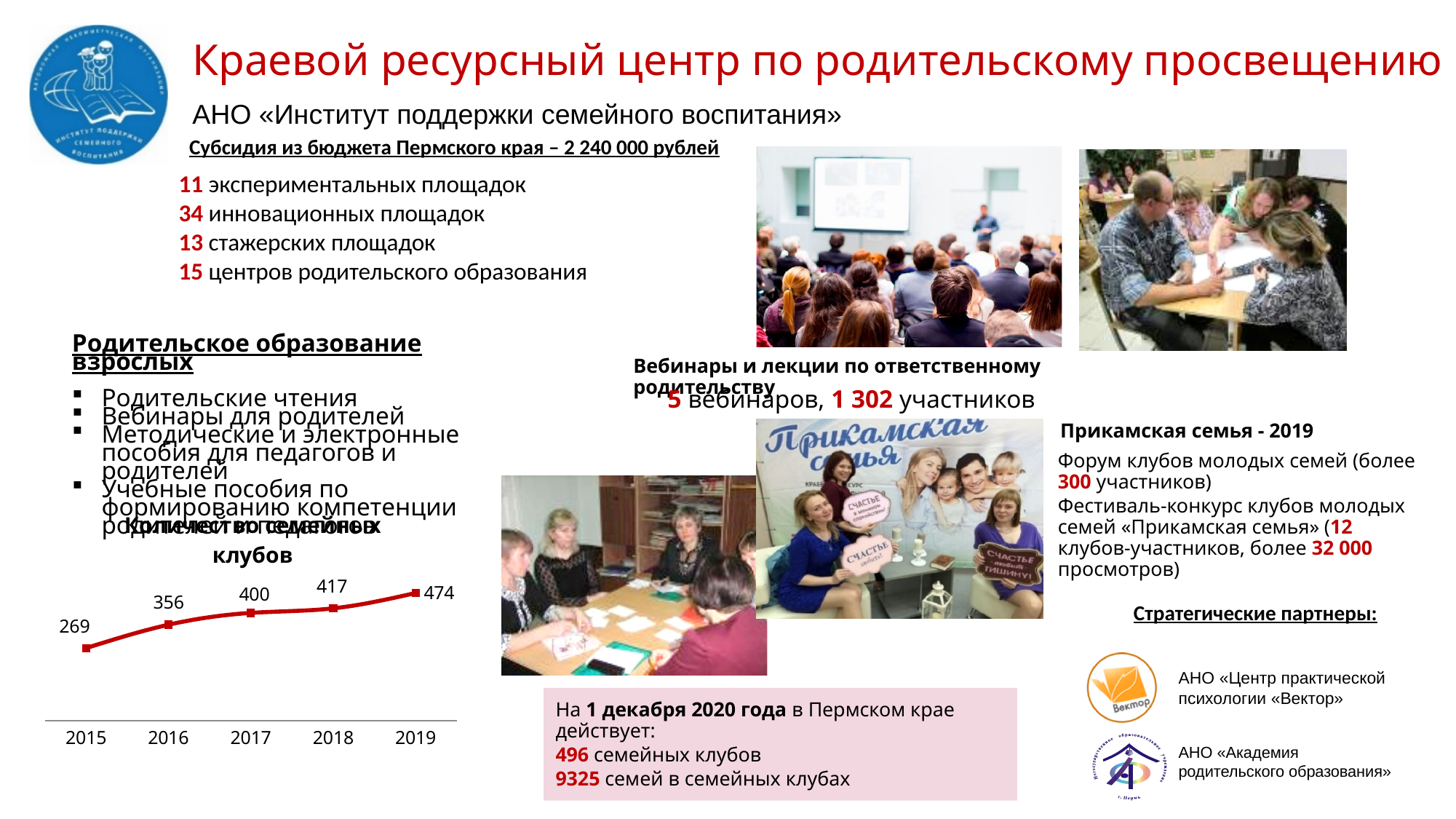
What is the value for 2016 in the line chart? 356 What is the value for 2019 in the line chart? 474 How many years are plotted in the line chart? 5 Which year has the highest value in the line chart? 2019 What is the difference between the values for 2019 and 2015 in the line chart? 205 What is the value for 2017 in the line chart? 400 Which is larger in the line chart, the value for 2016 or the value for 2018? 2018 What type of chart is shown on the slide? line chart Which year has the lowest value in the line chart? 2015 What is the value for 2015 in the line chart? 269 Do the values in the line chart rise or fall from 2015 to 2019? rise What is the difference between the values for 2018 and 2017 in the line chart? 17